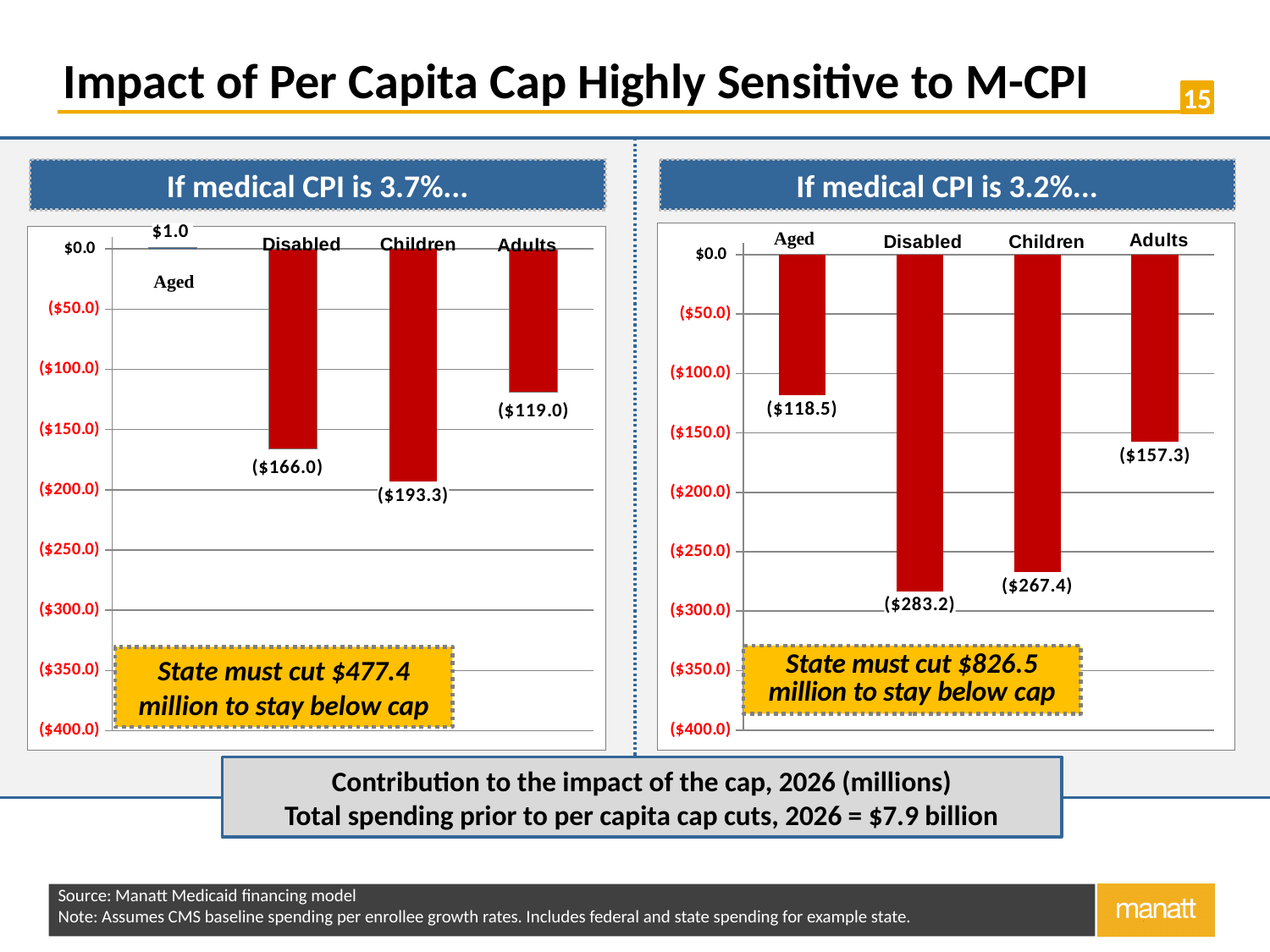
In the chart titled "If medical CPI is 3.2%...", what is the difference between the Disabled and Children values? $15.8 What type of chart is the chart titled "If medical CPI is 3.2%..."? Bar chart In the chart titled "If medical CPI is 3.7%...", what is the value for Aged? $1.0 In the chart titled "If medical CPI is 3.2%...", what is the value for Adults? ($157.3) In the chart titled "If medical CPI is 3.7%...", what is the value for Children? ($193.3) In the chart titled "If medical CPI is 3.2%...", which bar extends further below zero, Aged or Adults? Adults In the chart titled "If medical CPI is 3.2%...", what is the value for Disabled? ($283.2) In the chart titled "If medical CPI is 3.7%...", what is the difference between the Children and Adults values? $74.3 In the chart titled "If medical CPI is 3.2%...", which category has the lowest (most negative) value? Disabled In the chart titled "If medical CPI is 3.7%...", which category has the lowest (most negative) value? Children In the chart titled "If medical CPI is 3.2%...", which category has the highest value? Aged How many categories are shown in the chart titled "If medical CPI is 3.7%..."? 4